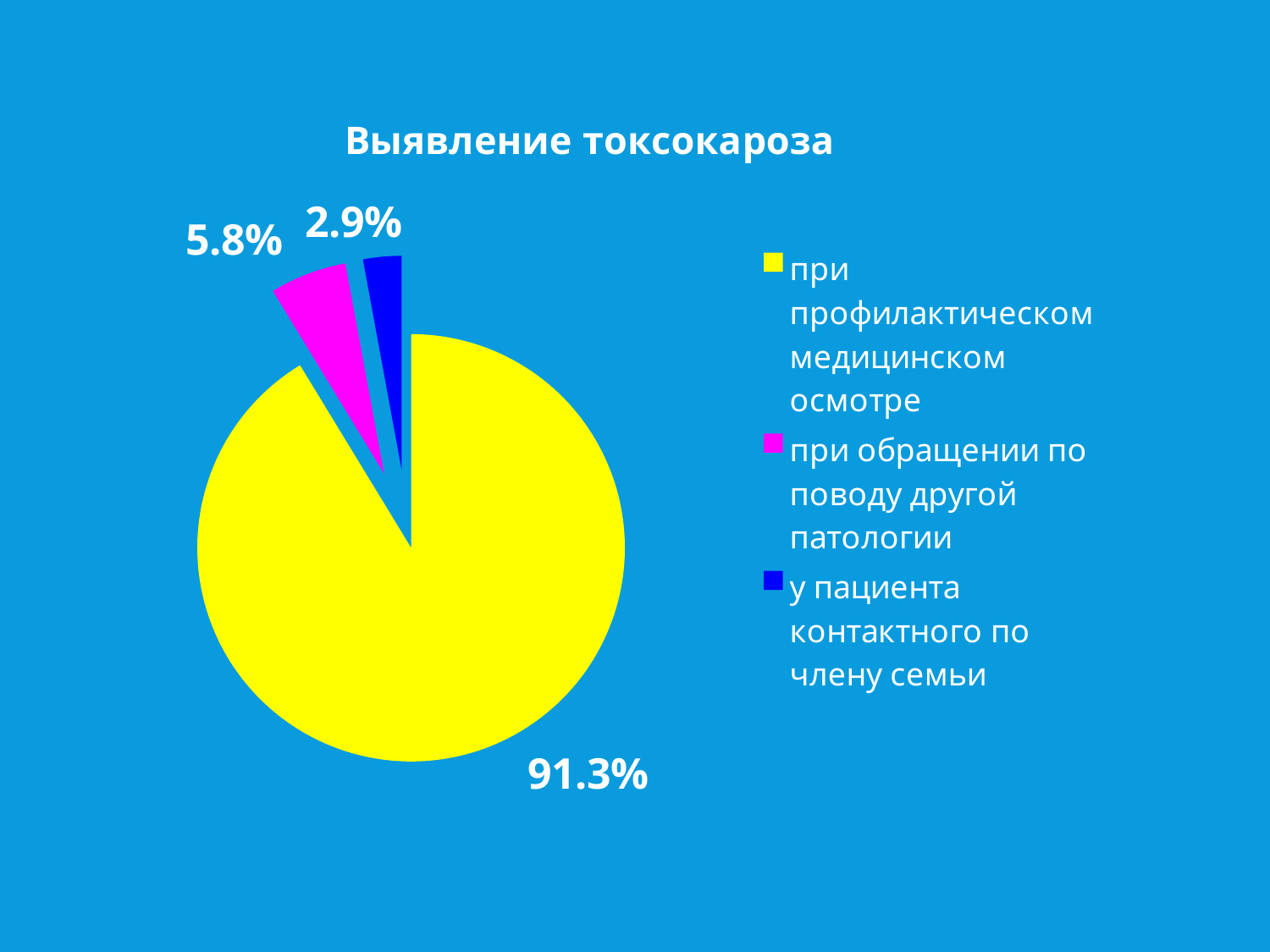
What kind of chart is shown on the slide? pie chart Which is larger: the value for 'при обращении по поводу другой патологии' or for 'у пациента контактного по члену семьи'? при обращении по поводу другой патологии How many categories does the pie chart show? 3 What is the value for 'при обращении по поводу другой патологии'? 5.8% Which category has the largest share of the pie? при профилактическом медицинском осмотре Which category has the smallest share of the pie? у пациента контактного по члену семьи What is the value for 'при профилактическом медицинском осмотре'? 91.3% What colour is the slice for 'при обращении по поводу другой патологии'? magenta What is the value for 'у пациента контактного по члену семьи'? 2.9% What is the difference between the values for 'при обращении по поводу другой патологии' and 'у пациента контактного по члену семьи'? 2.9% What is the difference between the values for 'при профилактическом медицинском осмотре' and 'при обращении по поводу другой патологии'? 85.5% What is the title of the chart? Выявление токсокароза